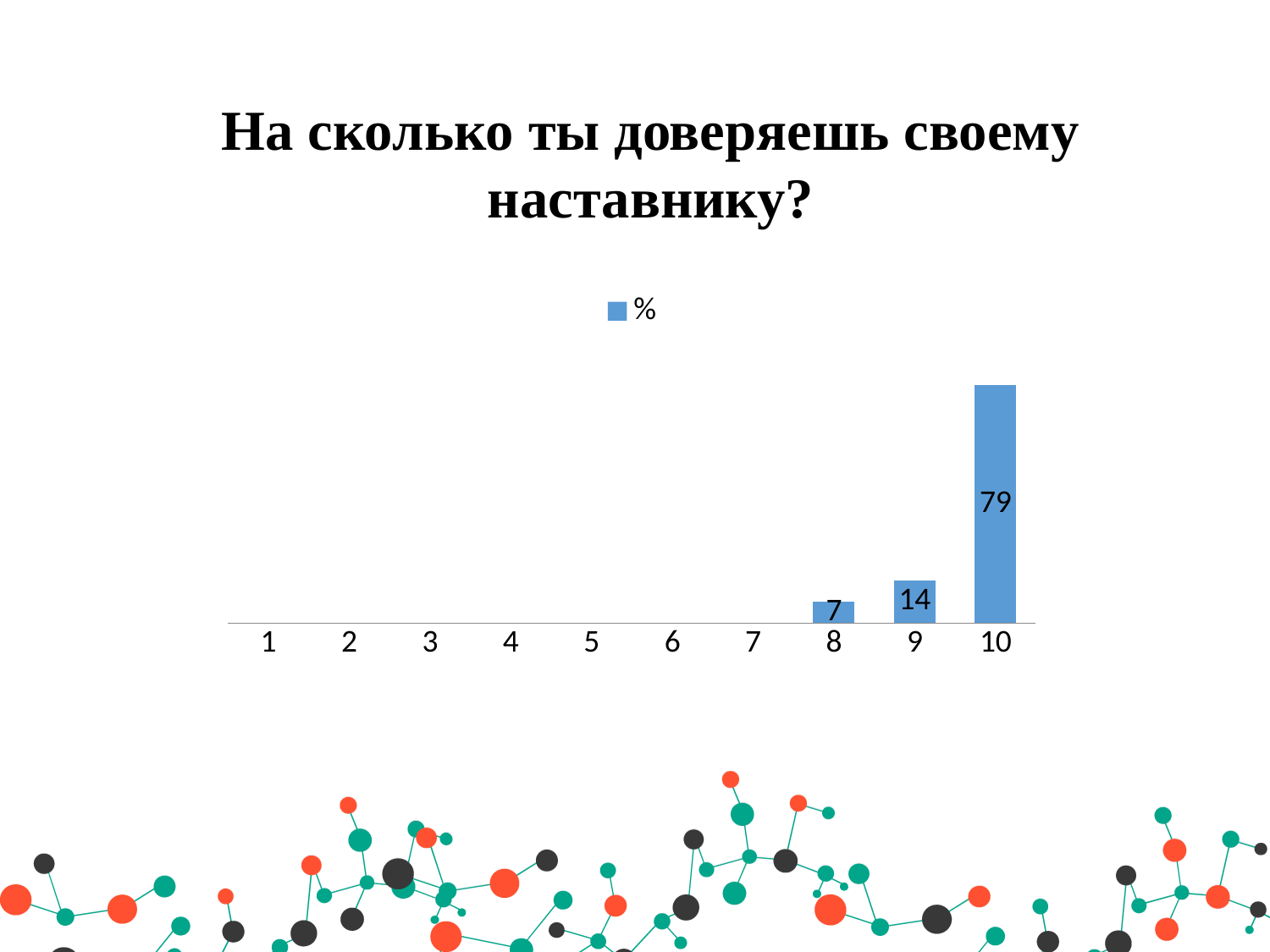
Which is larger, the value for category 9 or the value for category 8? 9 What is the legend entry for the series? % How many categories are shown on the x axis? 10 What is the difference between the values for categories 9 and 8? 7 What is the value for category 10? 79 Do the values rise or fall from category 8 to category 10? rise What is the value for category 8? 7 What is the difference between the values for categories 10 and 9? 65 Which category has the highest value? 10 What kind of chart is shown on the slide? bar chart How many series does the legend list? 1 What is the value for category 9? 14